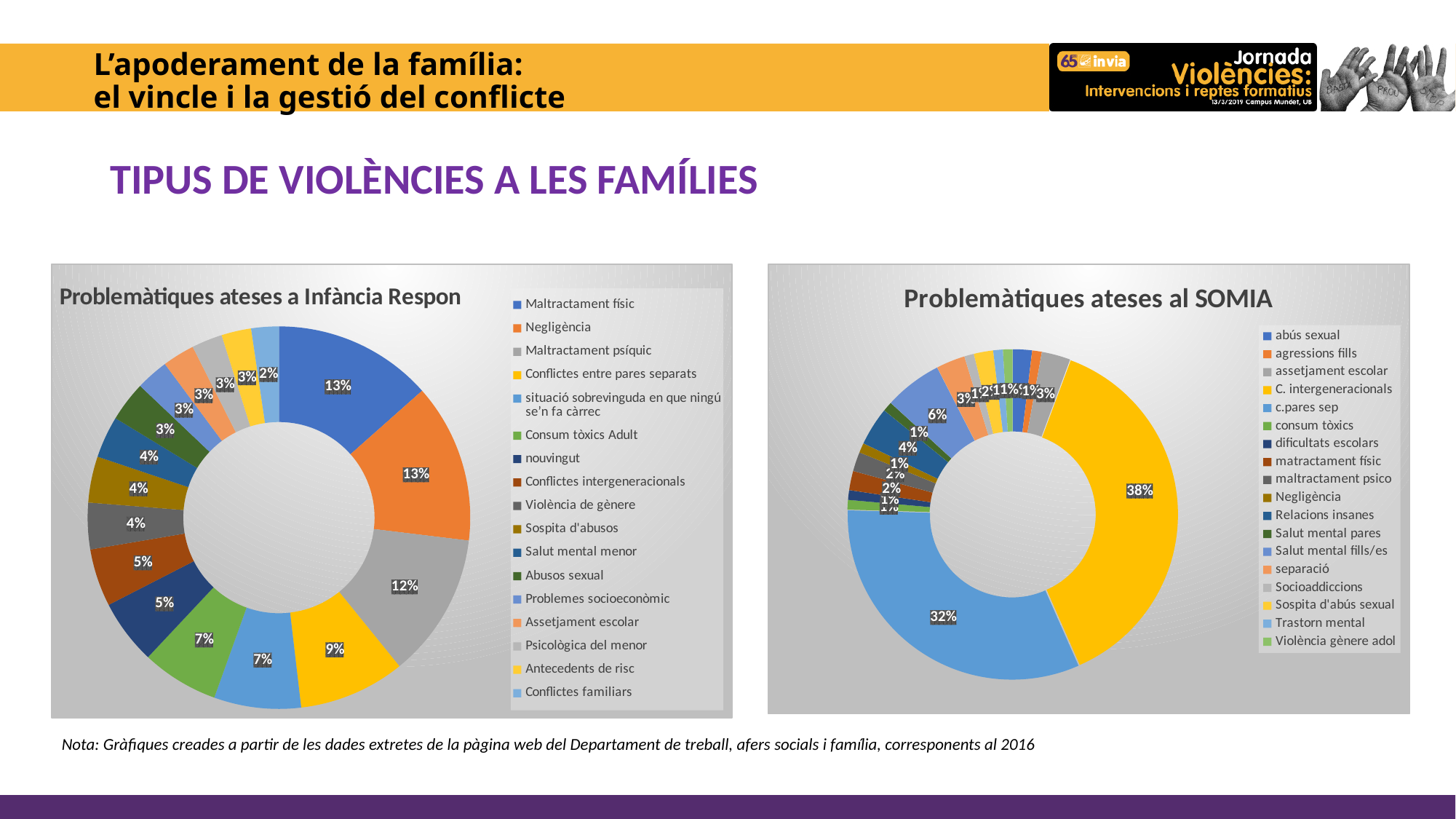
In the "Problemàtiques ateses a Infància Respon" chart, what share does Maltractament psíquic have? 12% How many categories does the legend of "Problemàtiques ateses a Infància Respon" list? 17 In the "Problemàtiques ateses a Infància Respon" chart, what share does Conflictes entre pares separats have? 9% In the "Problemàtiques ateses a Infància Respon" chart, which category has the smallest share? Conflictes familiars In the "Problemàtiques ateses al SOMIA" chart, what share does c.pares sep have? 32% How many categories does the legend of "Problemàtiques ateses al SOMIA" list? 18 In the "Problemàtiques ateses a Infància Respon" chart, which is larger: Consum tòxics Adult or nouvingut? Consum tòxics Adult In the "Problemàtiques ateses al SOMIA" chart, what is the difference between the shares of C. intergeneracionals and c.pares sep? 6% What kind of chart is "Problemàtiques ateses a Infància Respon"? Doughnut (pie) chart In the "Problemàtiques ateses al SOMIA" chart, which category has the largest share? C. intergeneracionals